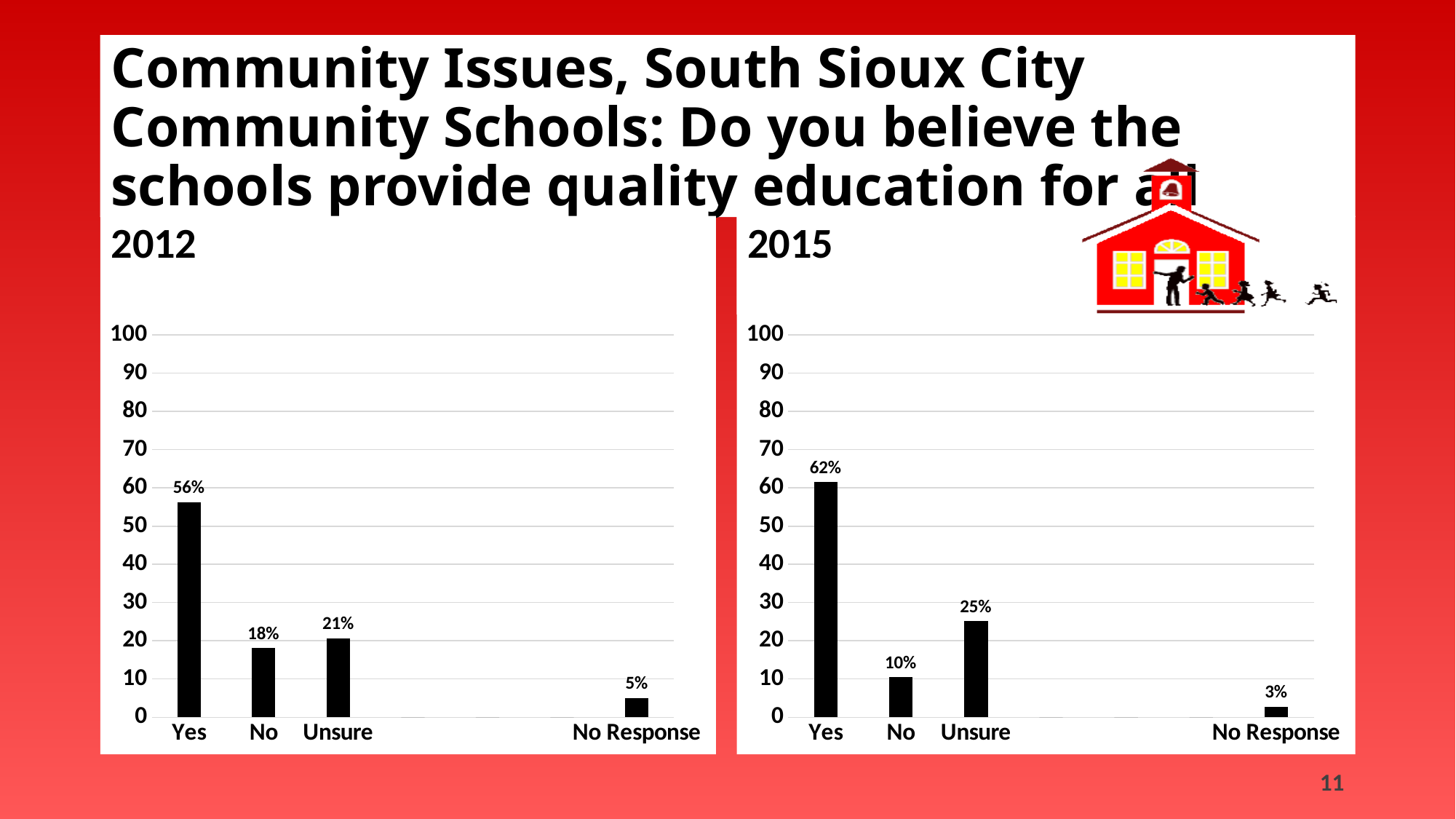
In the 2012 chart, what is the value for No Response? 5% In the 2015 chart, what is the value for Unsure? 25% In the 2015 chart, what is the difference between the values for Yes and No? 52% In the 2015 chart, which category has the highest value? Yes In the 2015 chart, what is the value for No Response? 3% Which is larger: the value for Yes in the 2012 chart or the value for Yes in the 2015 chart? 2015 In the 2012 chart, what is the value for Yes? 56% What kind of chart is the 2015 chart? bar chart In the 2012 chart, which category has the lowest value? No Response In the 2012 chart, what is the difference between the values for Unsure and No? 3% How many categories are shown on the x axis of the 2012 chart? 4 In the 2015 chart, is the value for No greater or less than 20? less